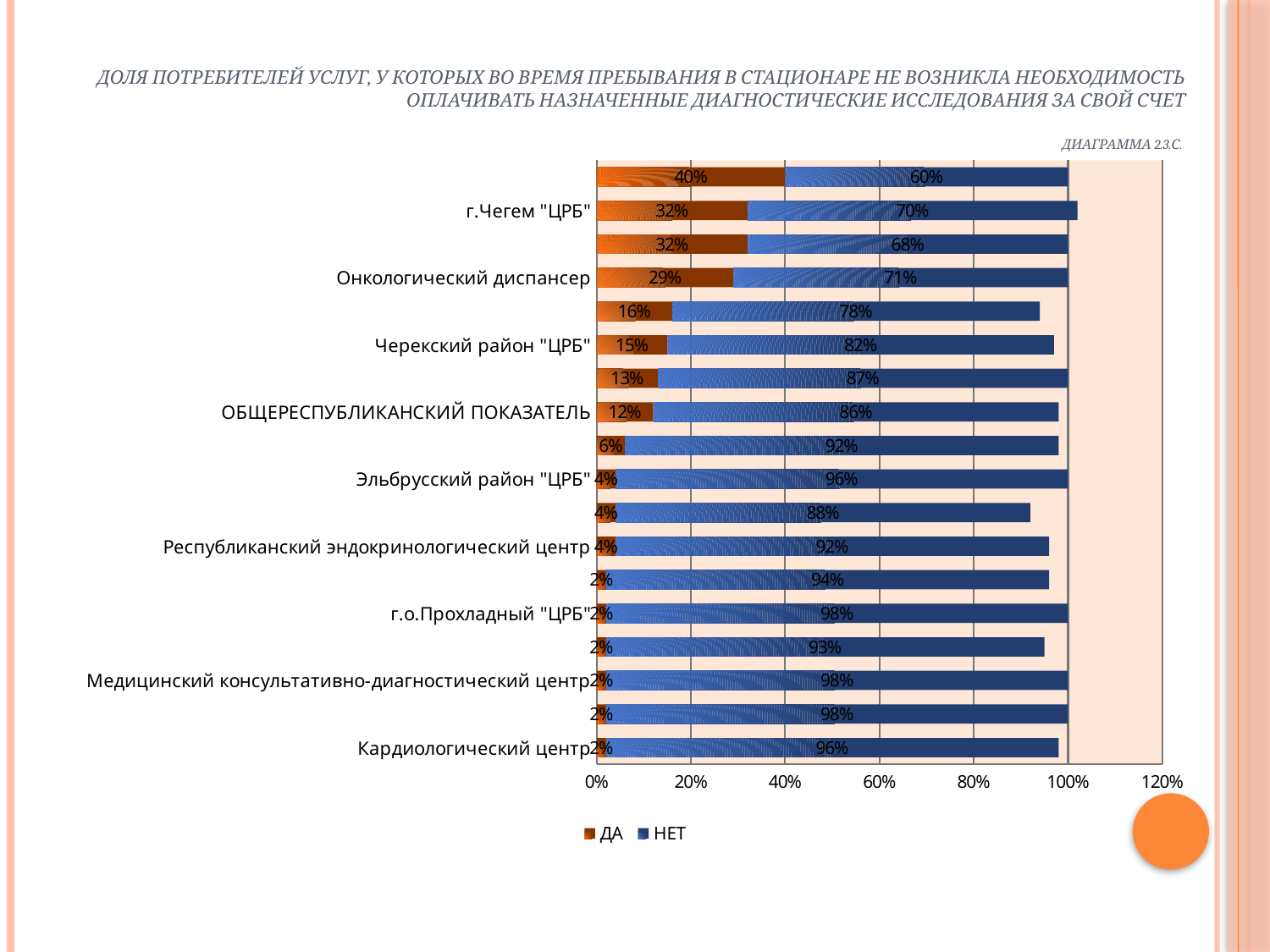
What is the difference between the НЕТ and ДА values for г.Чегем "ЦРБ"? 38% How many series does the legend list? 2 What kind of chart is shown on the slide? Stacked bar chart What is the НЕТ value for Кардиологический центр? 96% What is the НЕТ value for Онкологический диспансер? 71% What are the two legend entries of the chart? ДА and НЕТ What is the НЕТ value for Эльбрусский район "ЦРБ"? 96% Which has the larger ДА value: Онкологический диспансер or Черекский район "ЦРБ"? Онкологический диспансер What is the ДА value for г.Чегем "ЦРБ"? 32% What is the НЕТ value for Черекский район "ЦРБ"? 82% What is the ДА value for ОБЩЕРЕСПУБЛИКАНСКИЙ ПОКАЗАТЕЛЬ? 12% How many bars are plotted in the chart? 18